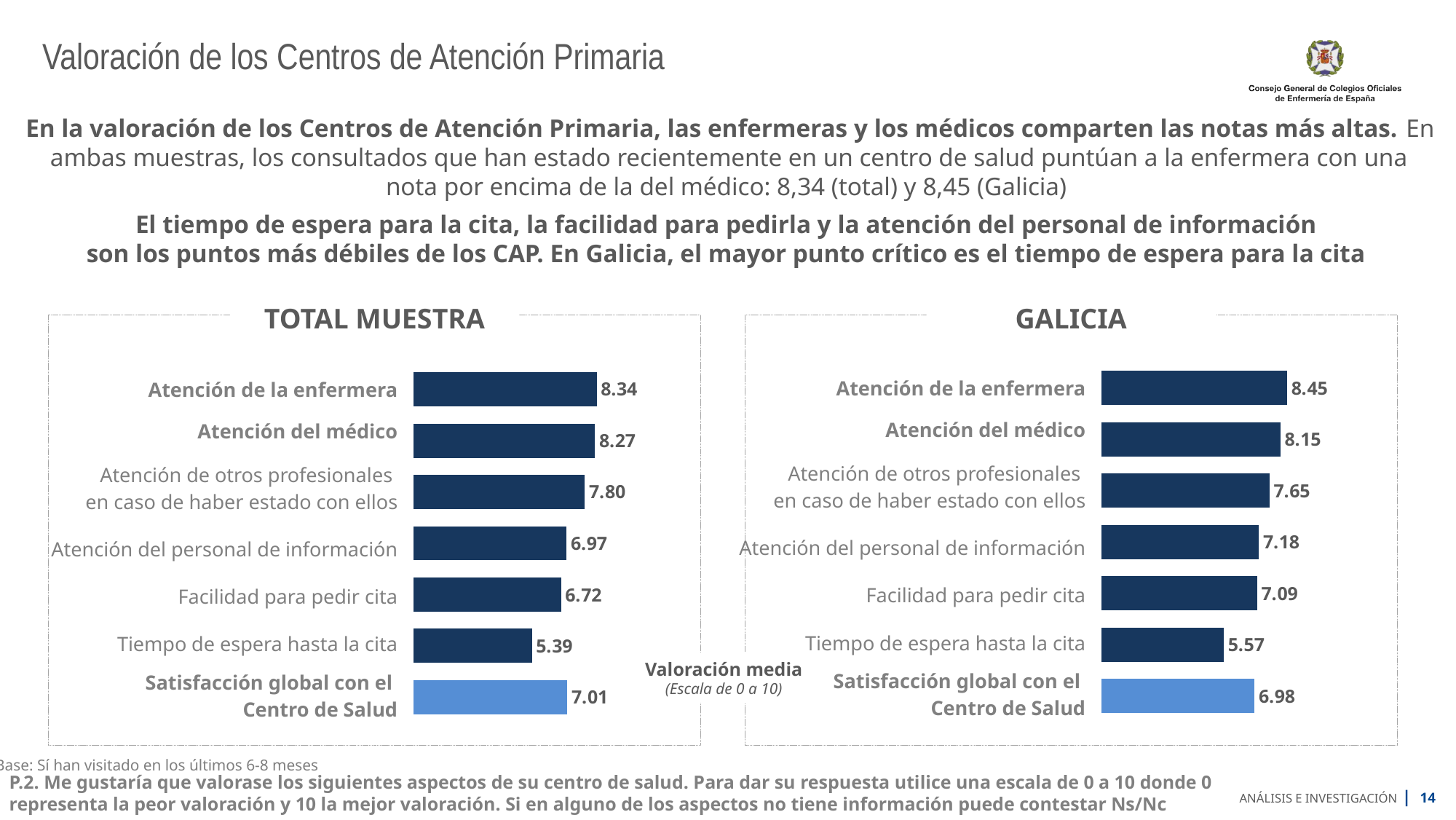
In the TOTAL MUESTRA chart, which category has the lowest value? Tiempo de espera hasta la cita In the TOTAL MUESTRA chart, what is the value for Atención de la enfermera? 8.34 In the TOTAL MUESTRA chart, which bar is shown in a lighter blue colour than the others? Satisfacción global con el Centro de Salud What scale is indicated for the Valoración media shown in the charts? Escala de 0 a 10 In the GALICIA chart, what is the value for Satisfacción global con el Centro de Salud? 6.98 In the GALICIA chart, which is larger: Atención del médico or Atención de otros profesionales en caso de haber estado con ellos? Atención del médico In the TOTAL MUESTRA chart, what is the difference between Atención de la enfermera and Atención del médico? 0.07 In the GALICIA chart, which category has the highest value? Atención de la enfermera In the GALICIA chart, what is the value for Tiempo de espera hasta la cita? 5.57 In the GALICIA chart, what is the difference between Atención del personal de información and Facilidad para pedir cita? 0.09 What kind of chart is the GALICIA chart? Bar chart How many categories are shown in the TOTAL MUESTRA chart? 7